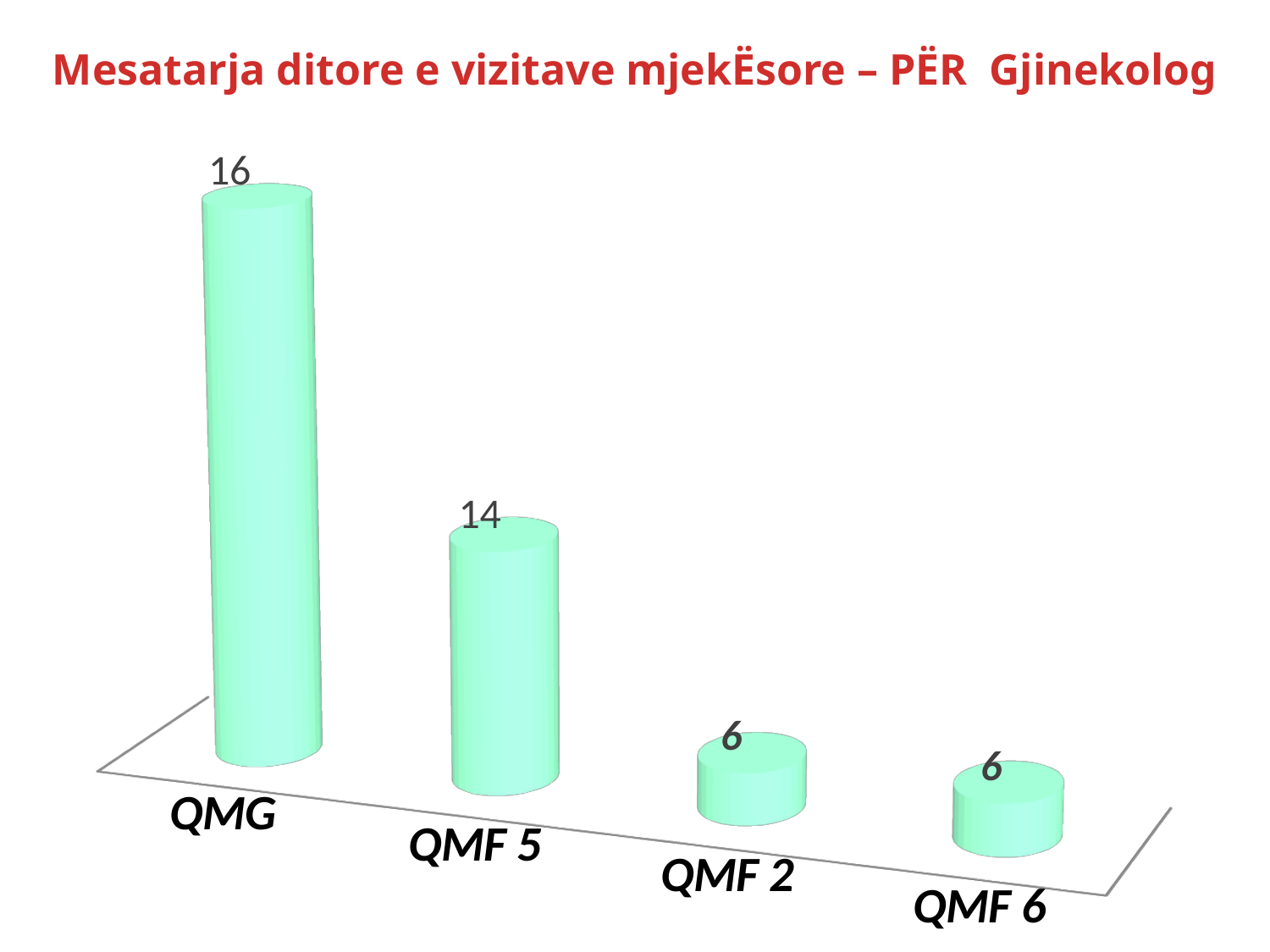
What is the value for QMF 5? 14 What kind of chart is shown on the slide? bar chart How many categories are shown in the chart? 4 Which is larger, the value for QMG or the value for QMF 2? QMG What is the value for QMF 2? 6 What is the difference between the values for QMG and QMF 5? 2 What is the title of the chart? Mesatarja ditore e vizitave mjekËsore – PËR Gjinekolog What is the value for QMG? 16 Do the values rise or fall from QMG to QMF 2 along the x axis? fall What is the difference between the values for QMF 5 and QMF 2? 8 What is the value for QMF 6? 6 Which category has the highest value? QMG